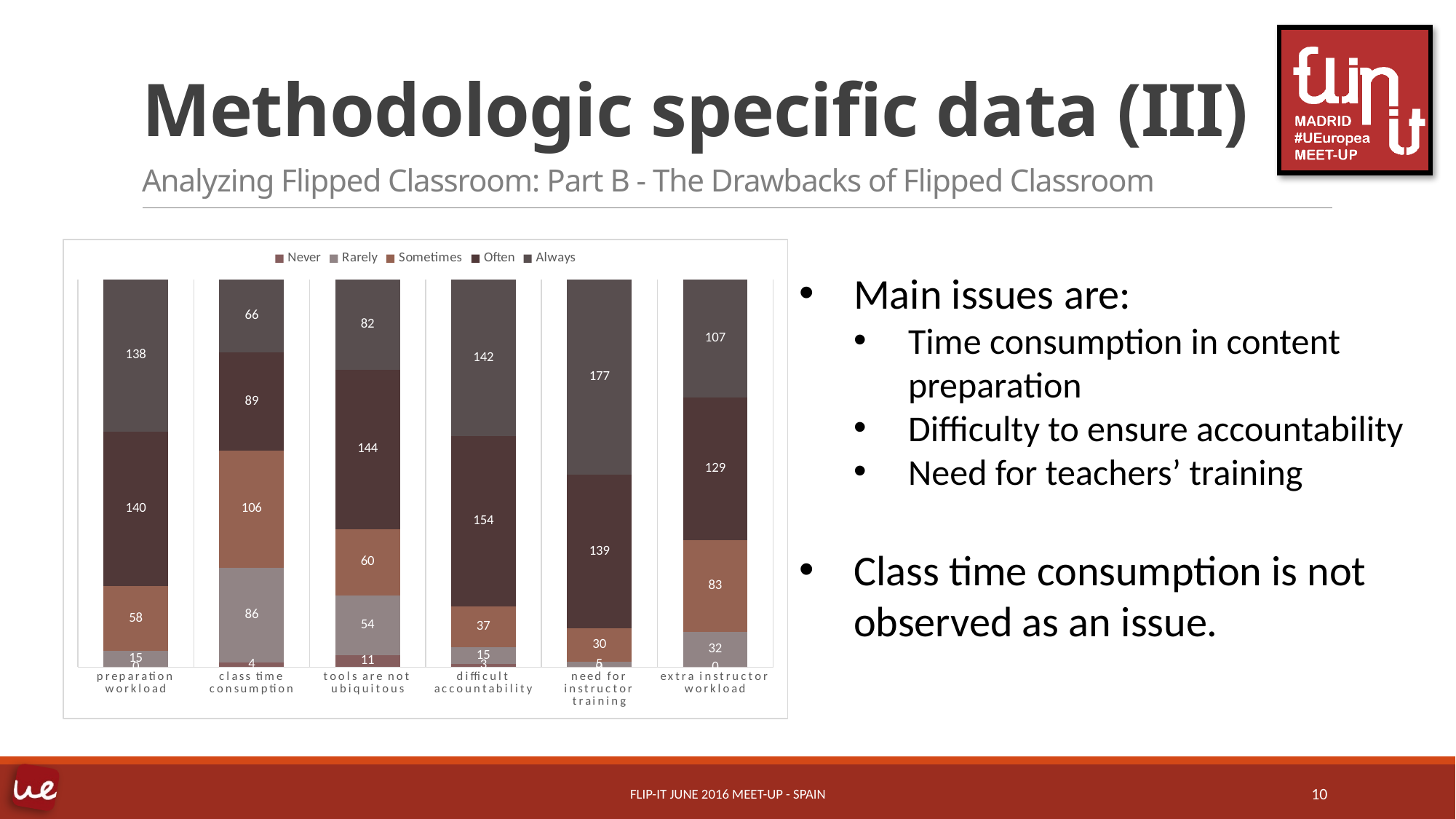
Which has the larger 'Often' value: 'tools are not ubiquitous' or 'difficult accountability'? difficult accountability Which category has the highest 'Always' value? need for instructor training What kind of chart is shown on the slide? Stacked bar chart How many categories are shown along the x axis of the chart? 6 Which category has the lowest 'Often' value? class time consumption What is the 'Always' value for 'need for instructor training'? 177 What is the total of the stacked bar for 'preparation workload'? 351 How many series does the chart legend list? 5 Which series is listed first in the chart legend? Never What is the 'Rarely' value for 'tools are not ubiquitous'? 54 For 'preparation workload', what is the difference between the 'Often' value and the 'Sometimes' value? 82 What is the 'Sometimes' value for 'class time consumption'? 106